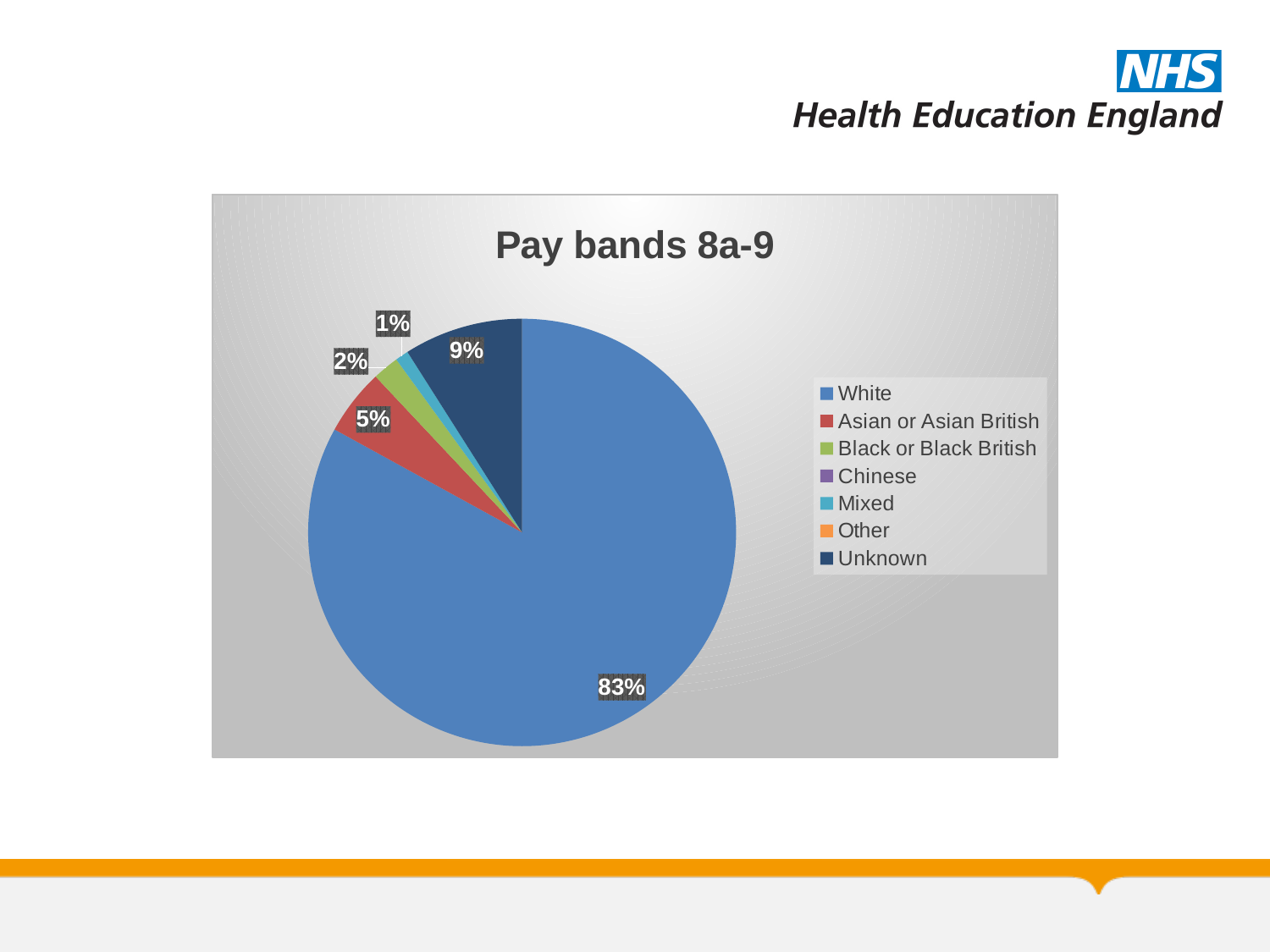
What share of the pie does the White slice represent? 83% What is the difference in percentage points between the White slice and the Unknown slice? 74 percentage points What percentage is shown for Asian or Asian British? 5% What colour is the slice for Unknown? Dark navy blue Which is larger, the slice for Asian or Asian British or the slice for Unknown? Unknown What percentage of the pie is labelled for White? 83% How many categories does the legend list? 7 What percentage is shown for Black or Black British? 2% Which category has the largest slice of the pie? White What kind of chart is shown on the slide? Pie chart What percentage is shown for Unknown? 9% What is the title of the chart? Pay bands 8a-9